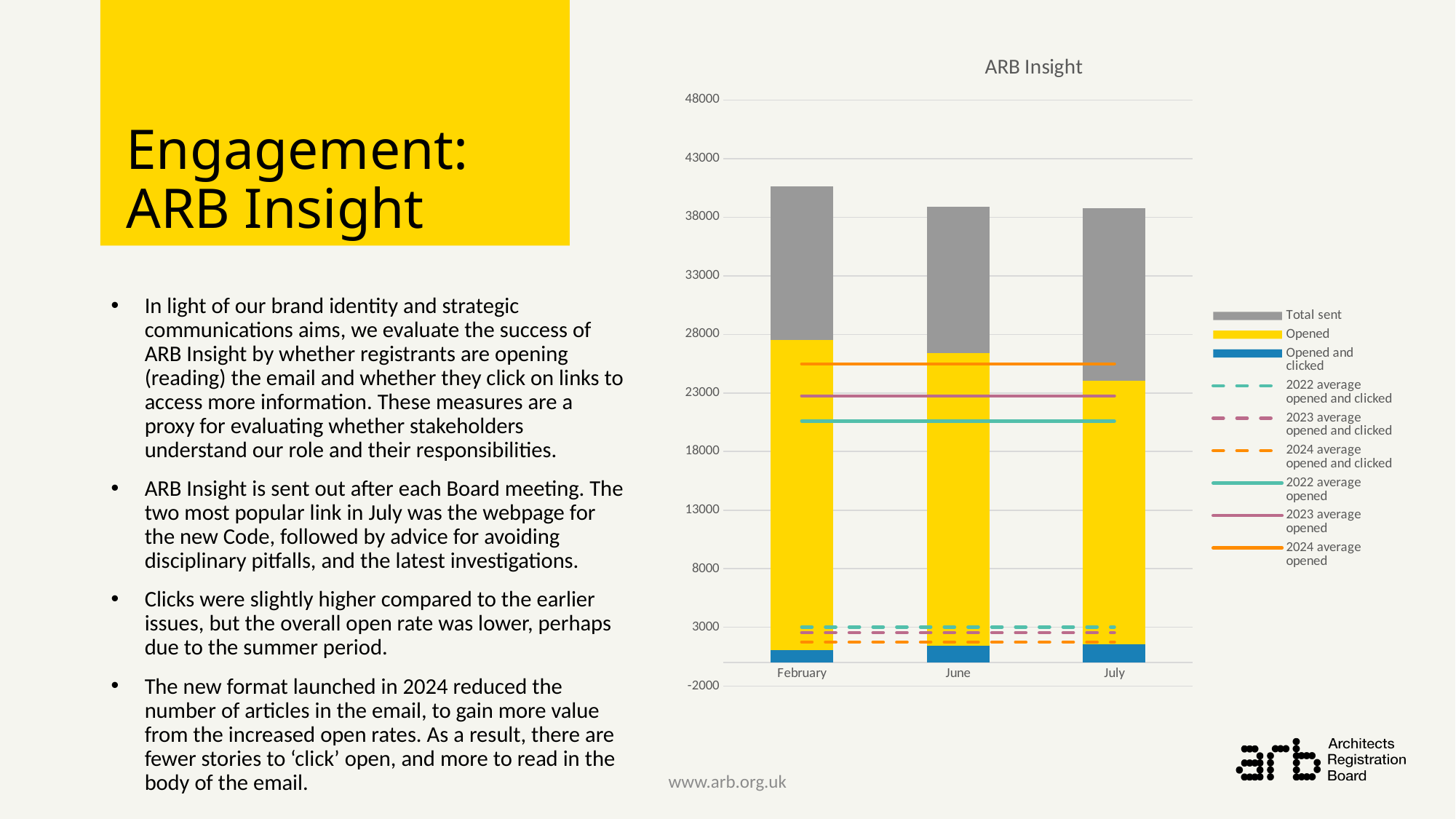
Which colour represents the Opened series in the chart? yellow Which month has the highest Opened bar? February How many months are shown on the x axis of the chart? 3 Which month has the highest Total sent bar? February What is the title of the chart? ARB Insight Is the Opened value for June larger or smaller than the Opened value for July? larger Is the Total sent value for February greater or less than 38000? greater Does the Opened value rise or fall from February to July? fall How many entries does the chart's legend list? 9 Which month has the lowest Opened bar? July What kind of chart is shown on the slide? combination bar and line chart Is the Opened value for July greater or less than 28000? less